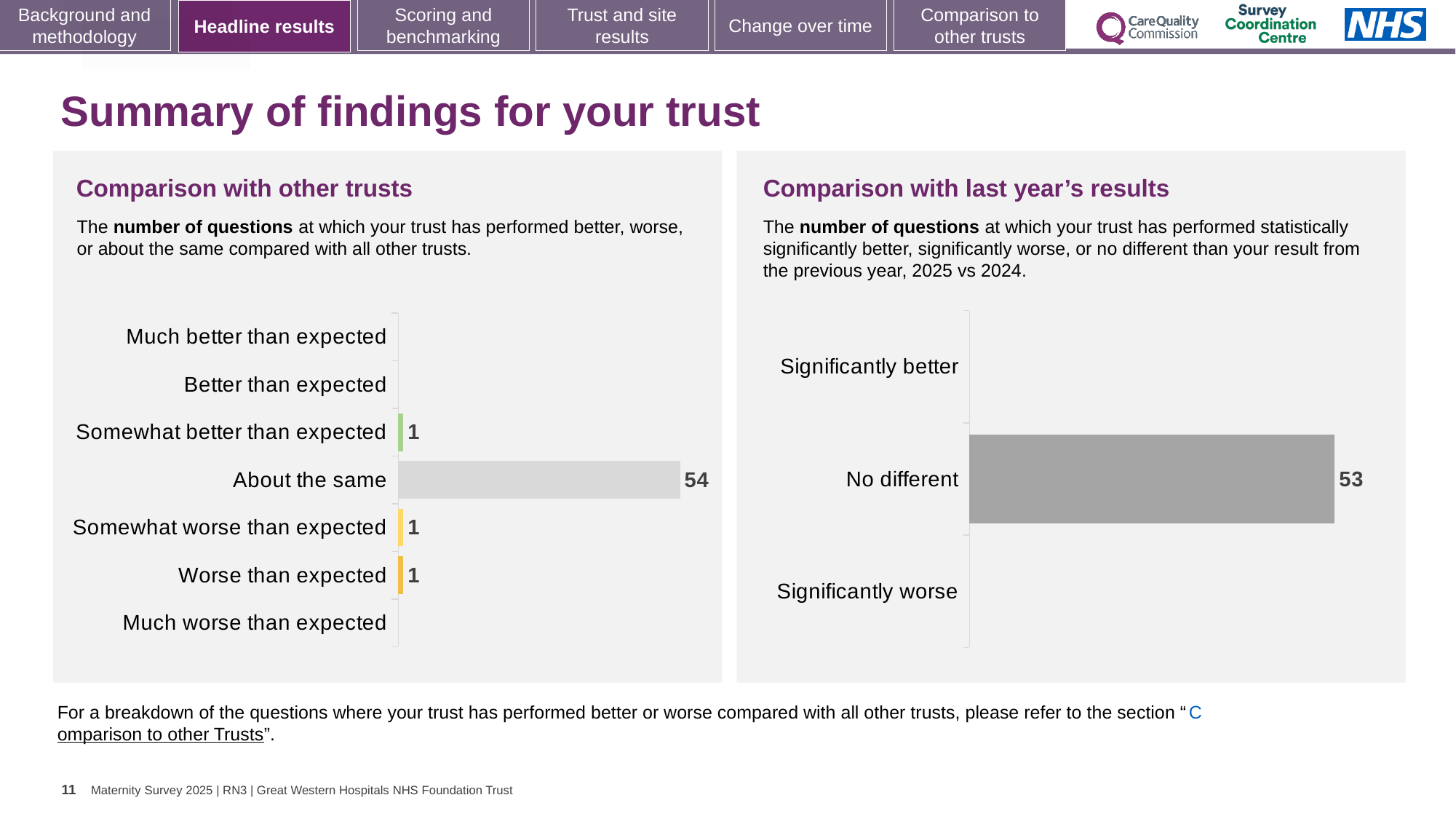
In the 'Comparison with other trusts' chart, how many categories are listed on the axis? 7 In the 'Comparison with other trusts' chart, what is the value for 'Worse than expected'? 1 In the 'Comparison with other trusts' chart, which category has the highest value? About the same In the 'Comparison with other trusts' chart, what is the difference between 'About the same' and 'Somewhat worse than expected'? 53 In the 'Comparison with other trusts' chart, how many questions are 'About the same'? 54 In the 'Comparison with other trusts' chart, what is the value for 'Somewhat better than expected'? 1 In the 'Comparison with other trusts' chart, what is the total of the three labelled bars other than 'About the same'? 3 In the 'Comparison with last year's results' chart, which category has the highest value? No different In the 'Comparison with last year's results' chart, what is the value for 'No different'? 53 What type of chart is used in the 'Comparison with last year's results' panel? Bar chart Which is larger: 'About the same' in the 'Comparison with other trusts' chart or 'No different' in the 'Comparison with last year's results' chart? About the same In the 'Comparison with last year's results' chart, how many categories are listed on the axis? 3